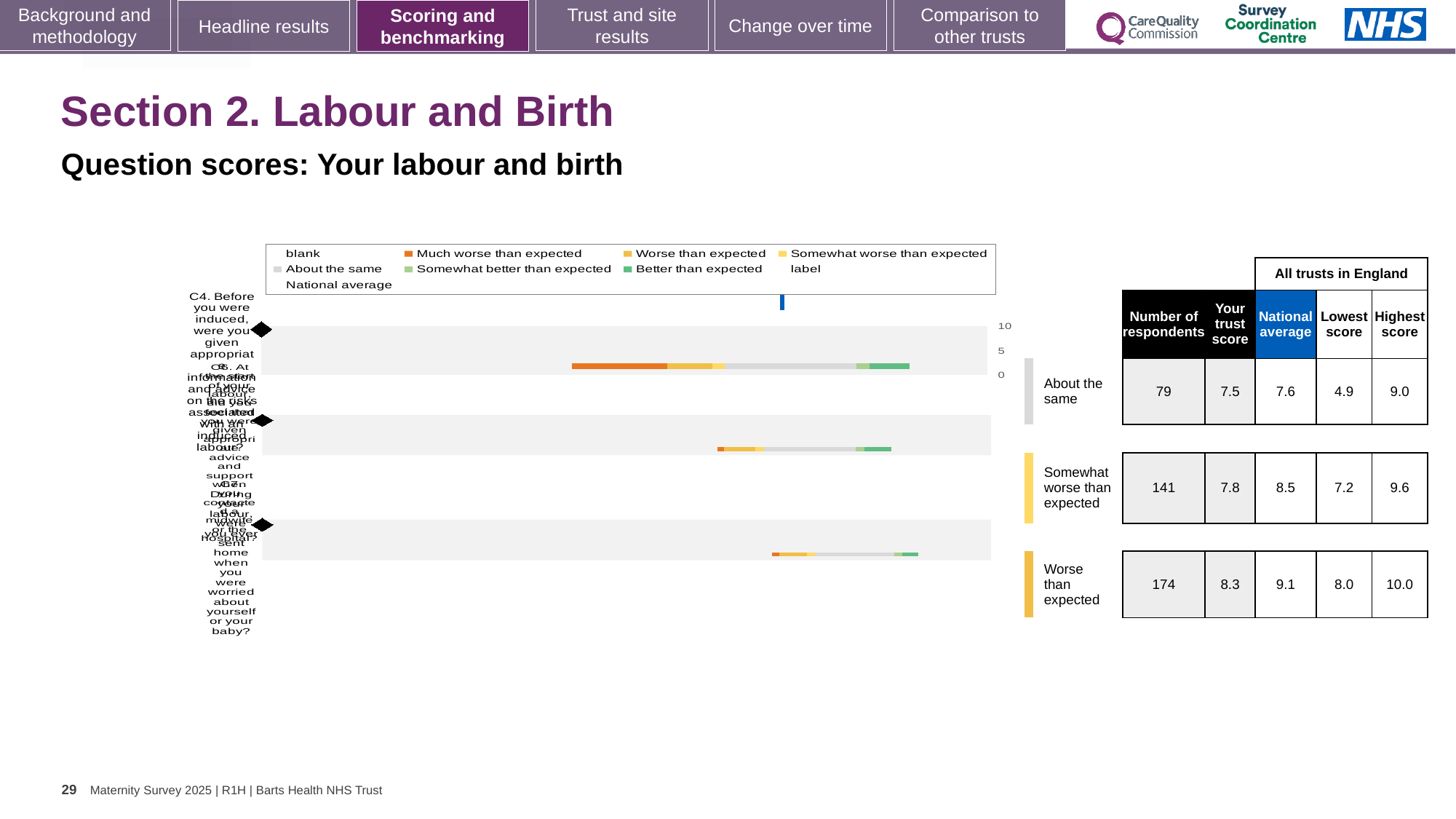
What kind of chart is shown on the slide? Bar chart Is the trust score or the national average larger for the row rated 'Somewhat worse than expected'? National average Which row has the highest number of respondents? Worse than expected What is the national average for the row rated 'Somewhat worse than expected'? 8.5 What is the highest score across all trusts in England for the row rated 'Worse than expected'? 10.0 What is the number of respondents for the row rated 'About the same'? 79 What is the difference between the national average and the trust score for the row rated 'Worse than expected'? 0.8 Which row has the lowest trust score? About the same How many question rows are shown in the table? 3 What is the subtitle of the slide above the chart? Question scores: Your labour and birth What is the lowest score across all trusts in England for the row rated 'About the same'? 4.9 What is the trust score for the row rated 'Worse than expected'? 8.3